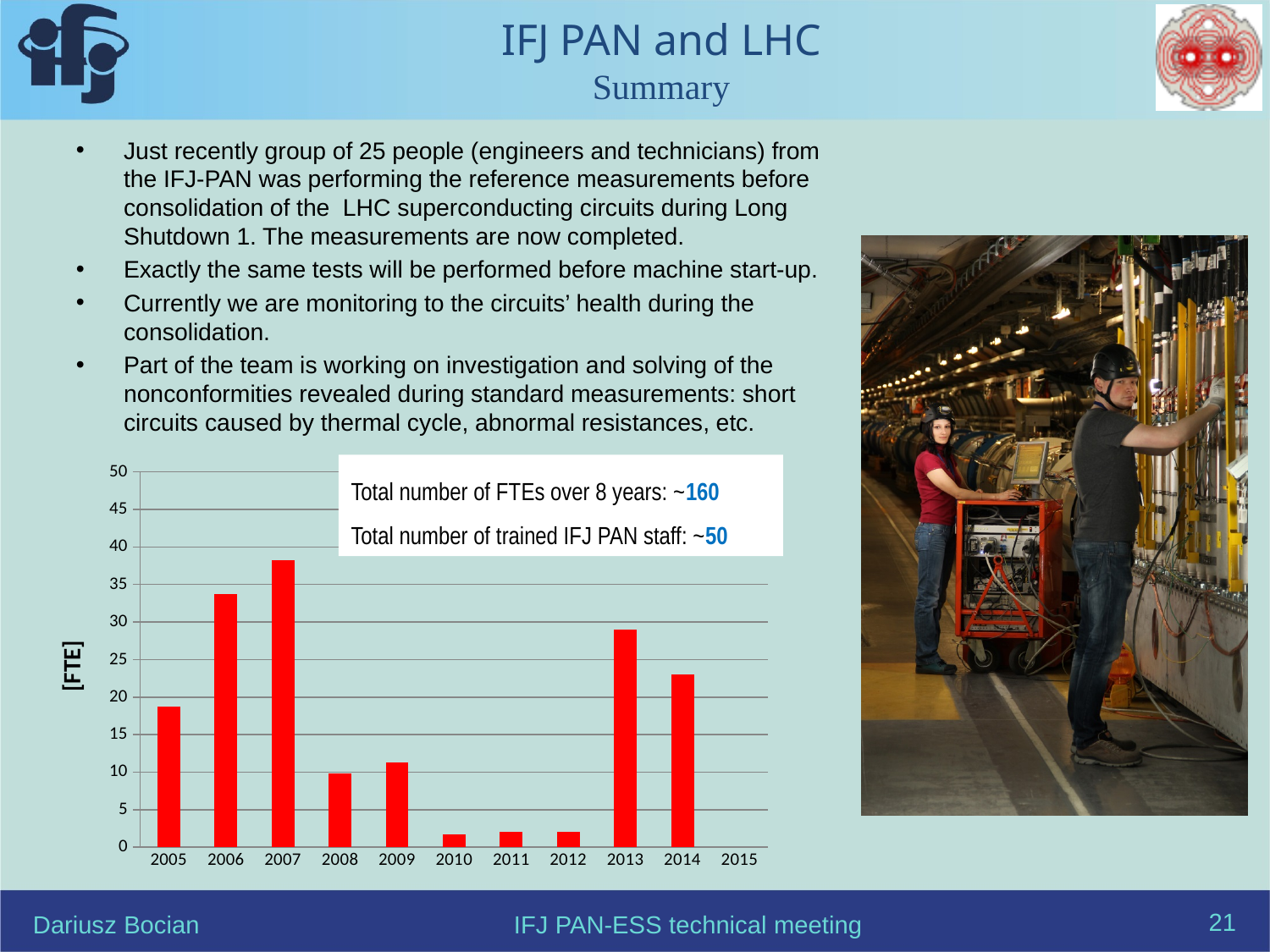
Which year has the larger FTE value, 2014 or 2007? 2007 Which year has the highest FTE value in the chart? 2007 Is the FTE value for 2007 greater or less than 35? greater Is the FTE value for 2008 greater or less than 15? less What is the label on the vertical axis of the chart? [FTE] Is the FTE value for 2005 greater or less than 15? greater What kind of chart is shown on the slide? bar chart Which year has the larger FTE value, 2006 or 2013? 2006 Do the FTE values rise or fall from 2007 to 2010? fall